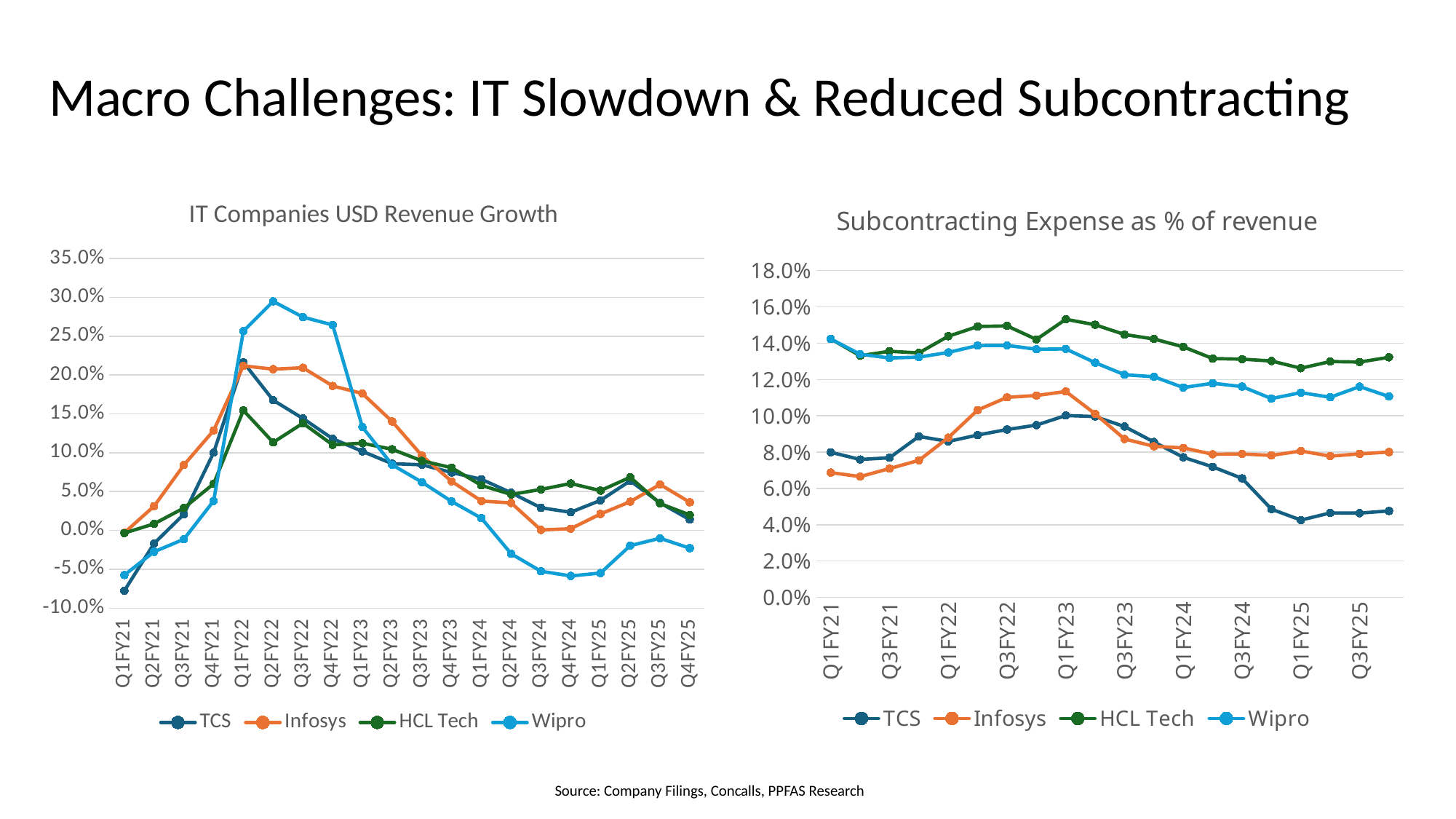
How many quarters are shown on the x axis of the 'IT Companies USD Revenue Growth' chart? 20 What kind of chart is the 'IT Companies USD Revenue Growth' chart? line chart In the 'Subcontracting Expense as % of revenue' chart, which company has the lowest value at Q1FY25? TCS In the 'Subcontracting Expense as % of revenue' chart, is the value for TCS at Q1FY25 greater or less than 6.0%? less In the 'IT Companies USD Revenue Growth' chart, which company has the lowest value at Q1FY21? TCS In the 'IT Companies USD Revenue Growth' chart, is the value for Infosys at Q1FY22 greater or less than 15.0%? greater In the 'IT Companies USD Revenue Growth' chart, is the value for Wipro at Q4FY24 greater or less than 0.0%? less In the 'IT Companies USD Revenue Growth' chart, which company has the highest value at Q2FY22? Wipro In the 'Subcontracting Expense as % of revenue' chart, which is larger at Q1FY21: TCS or Infosys? TCS In the 'Subcontracting Expense as % of revenue' chart, which company has the highest value at Q1FY23? HCL Tech How many series does the legend of the 'Subcontracting Expense as % of revenue' chart list? 4